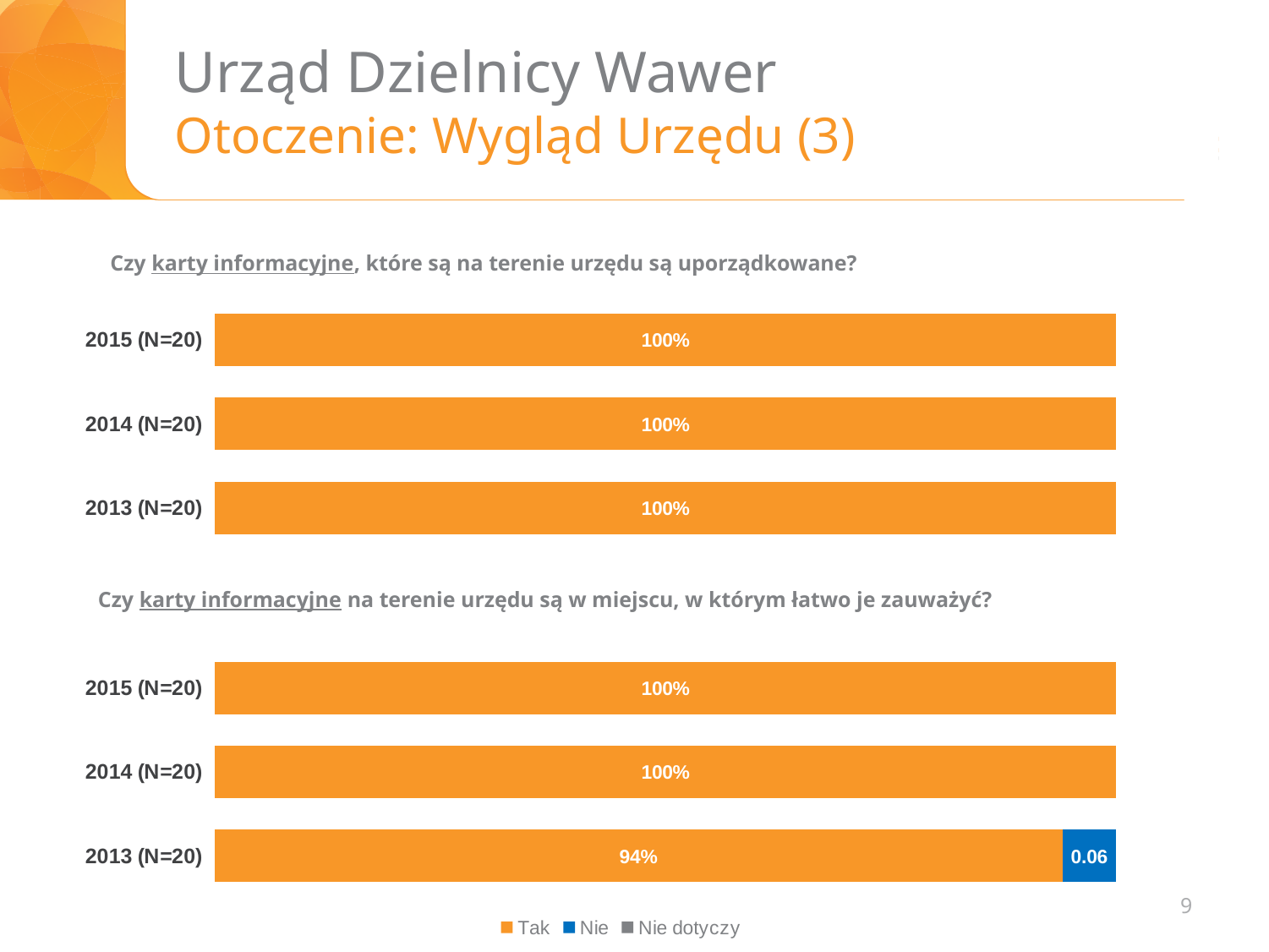
How many year categories does the top chart ("Czy karty informacyjne, które są na terenie urzędu są uporządkowane?") show? 3 In the bottom chart ("Czy karty informacyjne na terenie urzędu są w miejscu, w którym łatwo je zauważyć?"), is the "Tak" value for 2015 (N=20) larger or smaller than for 2013 (N=20)? larger In the bottom chart ("Czy karty informacyjne na terenie urzędu są w miejscu, w którym łatwo je zauważyć?"), what is the "Tak" value for 2013 (N=20)? 94% In the bottom chart ("Czy karty informacyjne na terenie urzędu są w miejscu, w którym łatwo je zauważyć?"), which year has the lowest "Tak" value? 2013 (N=20) In the bottom chart ("Czy karty informacyjne na terenie urzędu są w miejscu, w którym łatwo je zauważyć?"), what is the "Nie" value shown for 2013 (N=20)? 0.06 In the bottom chart ("Czy karty informacyjne na terenie urzędu są w miejscu, w którym łatwo je zauważyć?"), what is the "Tak" value for 2015 (N=20)? 100% What type of chart is the top chart ("Czy karty informacyjne, które są na terenie urzędu są uporządkowane?")? bar chart In the top chart ("Czy karty informacyjne, które są na terenie urzędu są uporządkowane?"), what is the value for 2014 (N=20)? 100% In the bottom chart ("Czy karty informacyjne na terenie urzędu są w miejscu, w którym łatwo je zauważyć?"), what colour is the "Nie" segment for 2013 (N=20)? blue In the bottom chart ("Czy karty informacyjne na terenie urzędu są w miejscu, w którym łatwo je zauważyć?"), what is the difference between the "Tak" value for 2014 (N=20) and for 2013 (N=20)? 6% What are the entries in the legend at the bottom of the slide? Tak, Nie, Nie dotyczy How many series does the legend at the bottom of the slide list? 3